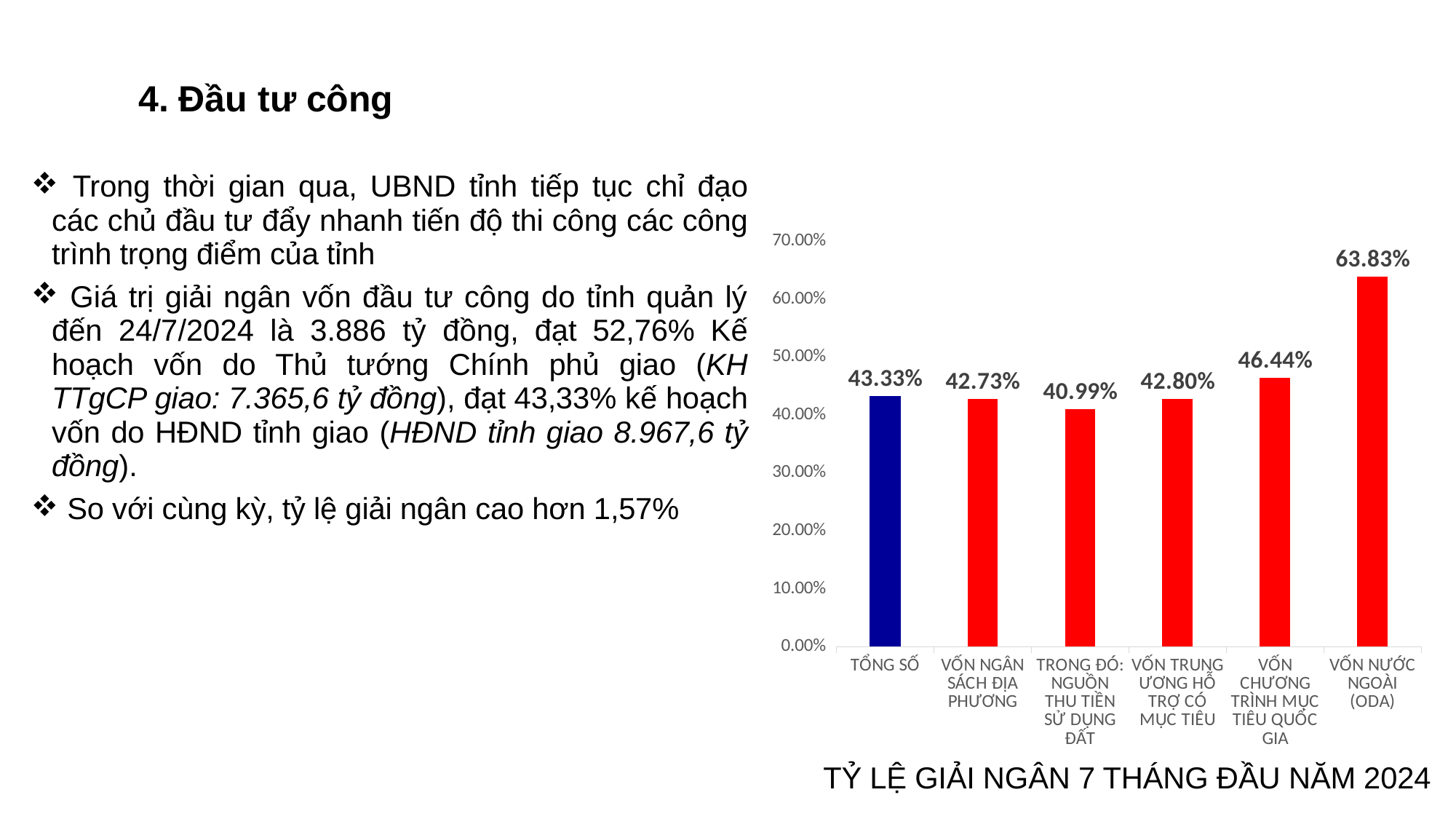
Is the value for VỐN NƯỚC NGOÀI (ODA) greater or less than 60.00%? greater What is the value for TỔNG SỐ? 43.33% Which category has the lowest value? TRONG ĐÓ: NGUỒN THU TIỀN SỬ DỤNG ĐẤT What is the value for VỐN CHƯƠNG TRÌNH MỤC TIÊU QUỐC GIA? 46.44% How many categories are shown on the chart? 6 Which is larger, the value for VỐN CHƯƠNG TRÌNH MỤC TIÊU QUỐC GIA or the value for VỐN NGÂN SÁCH ĐỊA PHƯƠNG? VỐN CHƯƠNG TRÌNH MỤC TIÊU QUỐC GIA What kind of chart is shown on the slide? bar chart Which category has the highest value? VỐN NƯỚC NGOÀI (ODA) What is the value for TRONG ĐÓ: NGUỒN THU TIỀN SỬ DỤNG ĐẤT? 40.99% What is the difference between the values for VỐN NƯỚC NGOÀI (ODA) and TỔNG SỐ? 20.50% What is the value for VỐN NƯỚC NGOÀI (ODA)? 63.83% What is the title of the chart? TỶ LỆ GIẢI NGÂN 7 THÁNG ĐẦU NĂM 2024